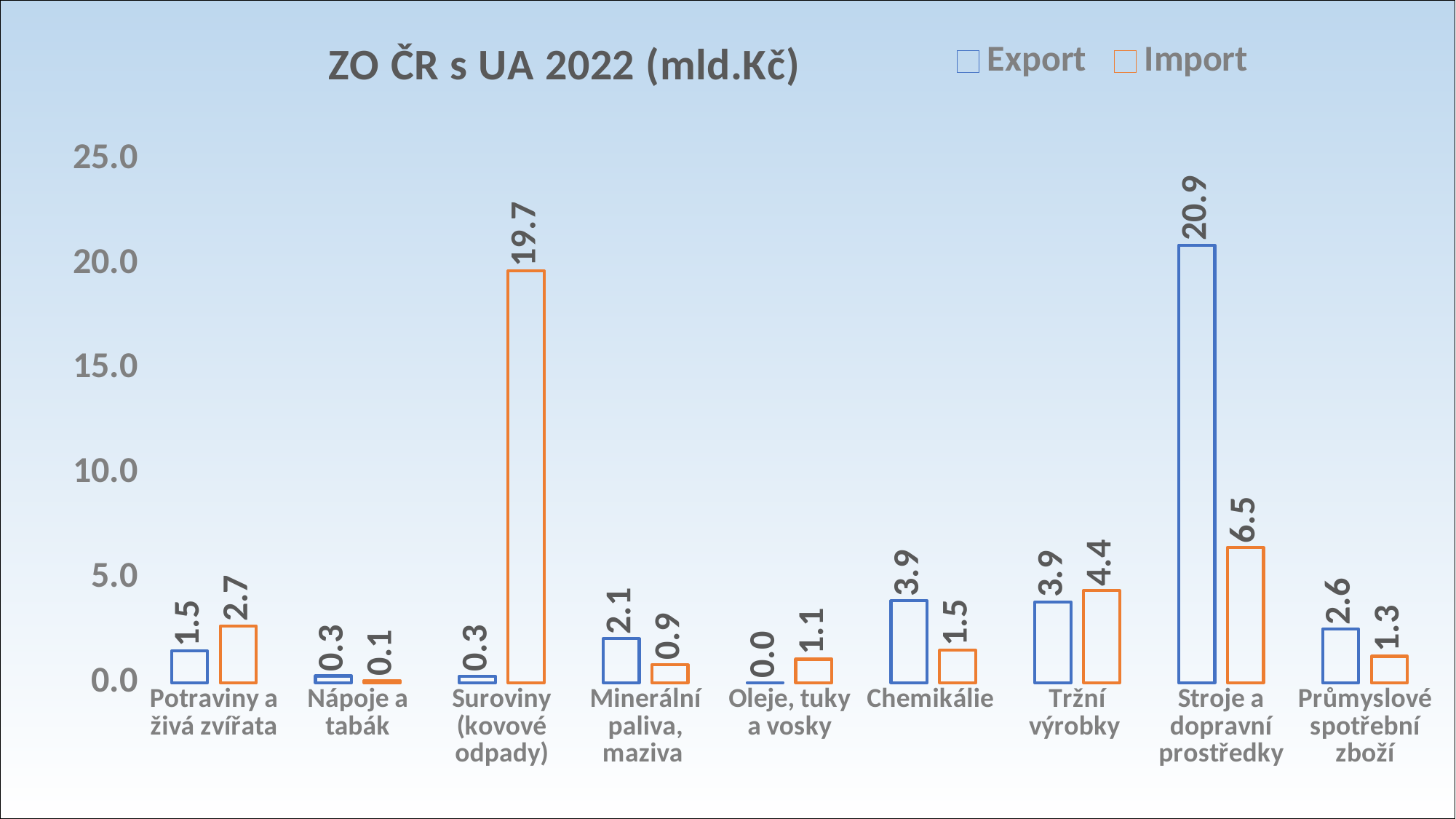
What is the Import value for Potraviny a živá zvířata? 2.7 What kind of chart is shown? Bar chart What is the Export value for Stroje a dopravní prostředky? 20.9 Which is larger for Tržní výrobky, Export or Import? Import What is the title of the chart? ZO ČR s UA 2022 (mld.Kč) What is the Export value for Oleje, tuky a vosky? 0.0 Which category has the lowest Import value? Nápoje a tabák How many categories are shown on the x axis? 9 What is the difference between Export and Import for Stroje a dopravní prostředky? 14.4 Which category has the highest Export value? Stroje a dopravní prostředky How many series does the legend list? 2 What is the Import value for Suroviny (kovové odpady)? 19.7